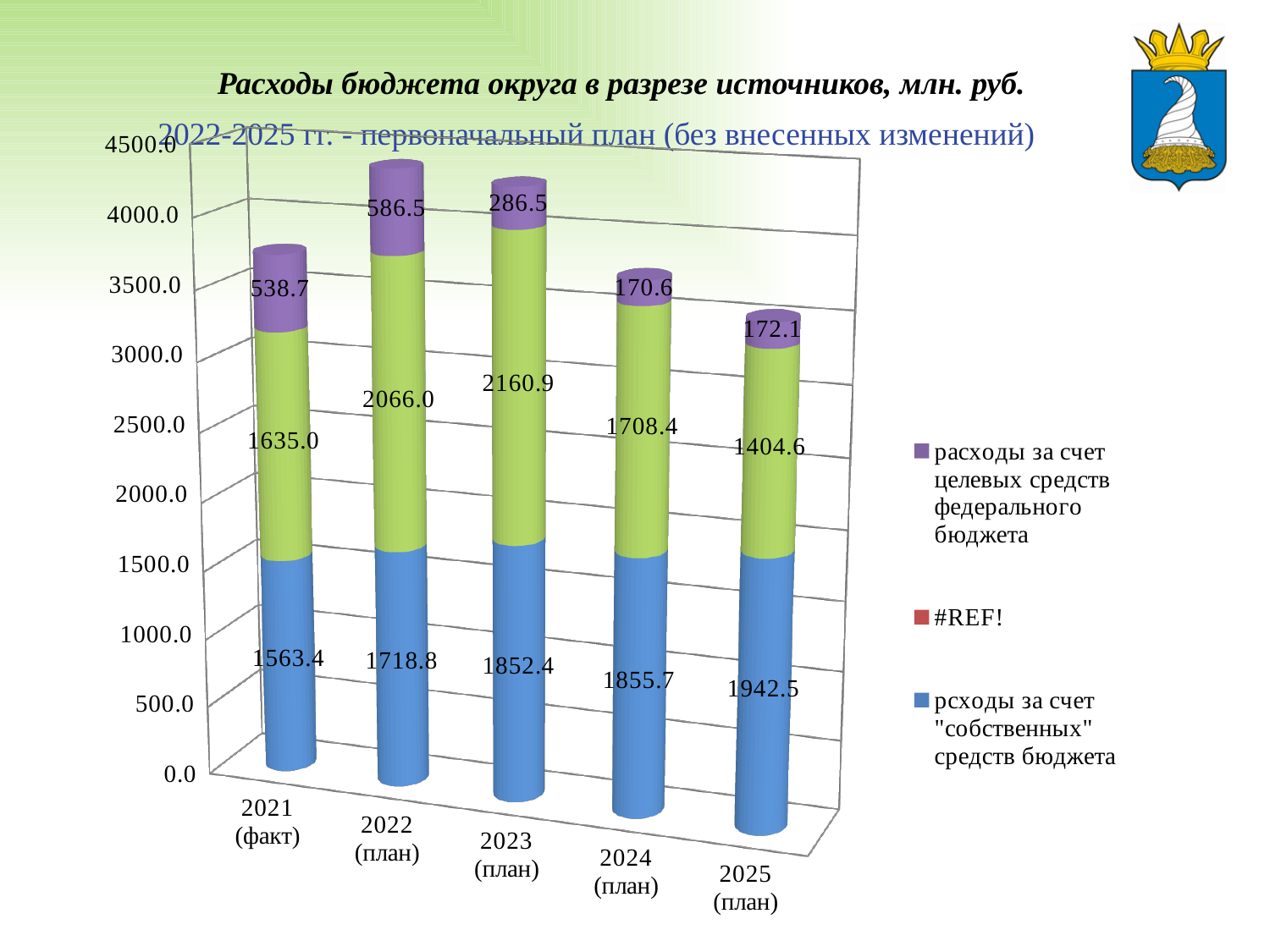
What is the value for 'рсходы за счет "собственных" средств бюджета' in 2025 (план)? 1942.5 How many series does the legend list? 3 What is the difference between the 'рсходы за счет "собственных" средств бюджета' values for 2025 (план) and 2021 (факт)? 379.1 In which category is the 'расходы за счет целевых средств федерального бюджета' value lowest? 2024 (план) In which category is the 'рсходы за счет "собственных" средств бюджета' value highest? 2025 (план) What is the value for 'расходы за счет целевых средств федерального бюджета' in 2021 (факт)? 538.7 What is the total of the stacked bar for 2022 (план)? 4371.3 Which is larger, the middle (green) segment for 2022 (план) or for 2023 (план)? 2023 (план) What kind of chart is shown on the slide? Stacked bar chart Do the 'рсходы за счет "собственных" средств бюджета' values rise or fall from 2021 (факт) to 2025 (план)? Rise How many categories are shown on the x axis? 5 What is the value of the middle (green) segment for 2023 (план)? 2160.9